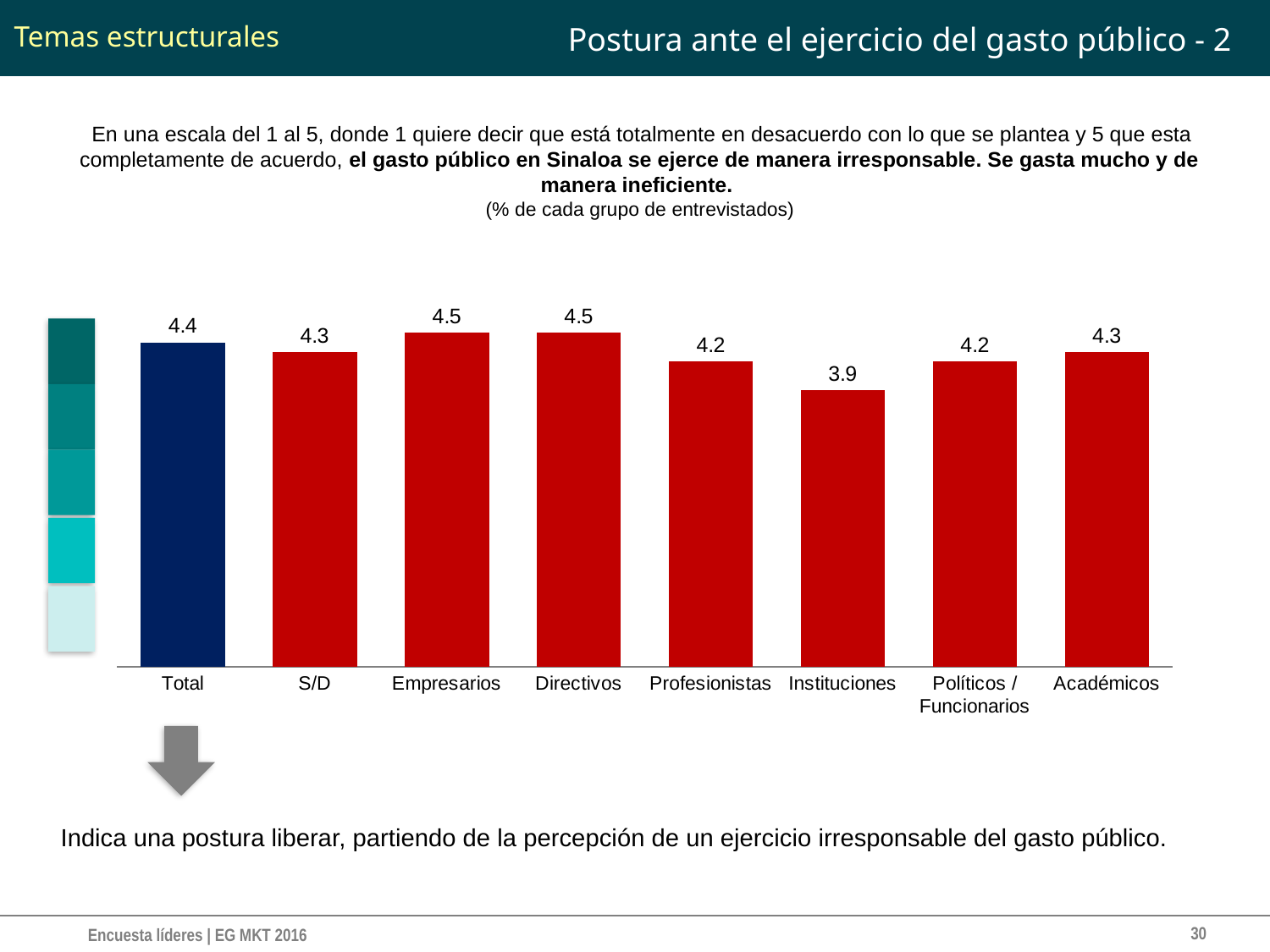
What is the value for Profesionistas? 4.2 Which category has the lowest value? Instituciones Which bar is shown in a different colour (dark blue) from the others? Total What is the value for Instituciones? 3.9 Which is larger, the value for Directivos or the value for Políticos / Funcionarios? Directivos What is the value for Académicos? 4.3 What kind of chart is shown on the slide? Bar chart Which is larger, the value for Instituciones or the value for Académicos? Académicos What is the value for Total? 4.4 What is the difference between the values for Total and S/D? 0.1 What is the difference between the values for Empresarios and Instituciones? 0.6 How many categories are shown on the x axis? 8